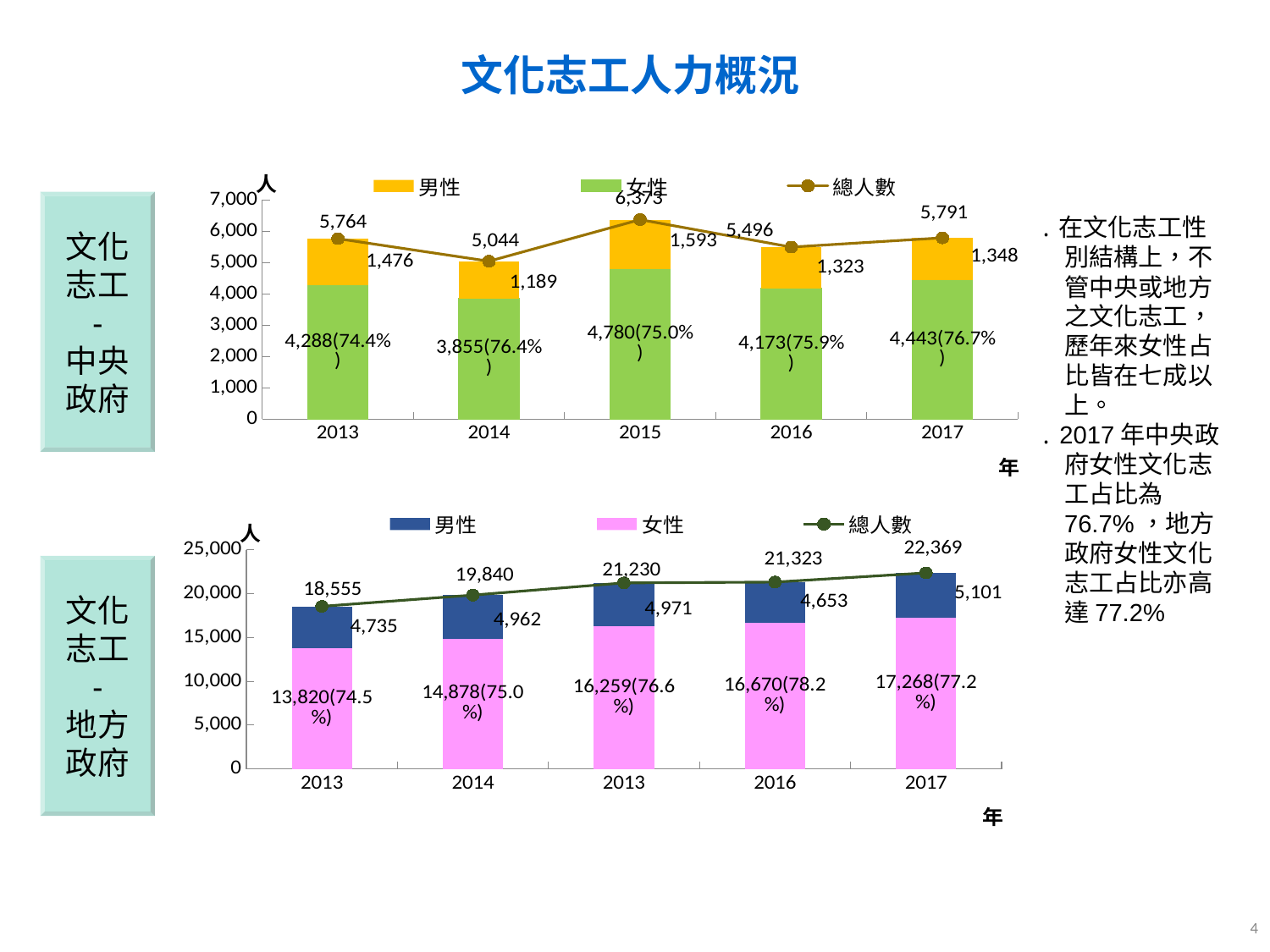
In the top chart (文化志工-中央政府), how many series does the legend list? 3 In the bottom chart (文化志工-地方政府), what is the 女性 value for 2017? 17,268 In the top chart (文化志工-中央政府), what is the difference between the 總人數 for 2017 and 2016? 295 In the top chart (文化志工-中央政府), which year has the lowest 總人數? 2014 In the top chart (文化志工-中央政府), which year has the highest 總人數? 2015 In the top chart (文化志工-中央政府), what is the 男性 value for 2014? 1,189 In the bottom chart (文化志工-地方政府), which year has the highest 總人數? 2017 In the bottom chart (文化志工-地方政府), is the 男性 value for 2017 larger or smaller than the 男性 value for 2016? larger What kind of chart is the bottom chart (文化志工-地方政府)? Stacked bar chart with a line In the bottom chart (文化志工-地方政府), what is the 總人數 value for 2016? 21,323 In the top chart (文化志工-中央政府), what is the 總人數 value for 2015? 6,373